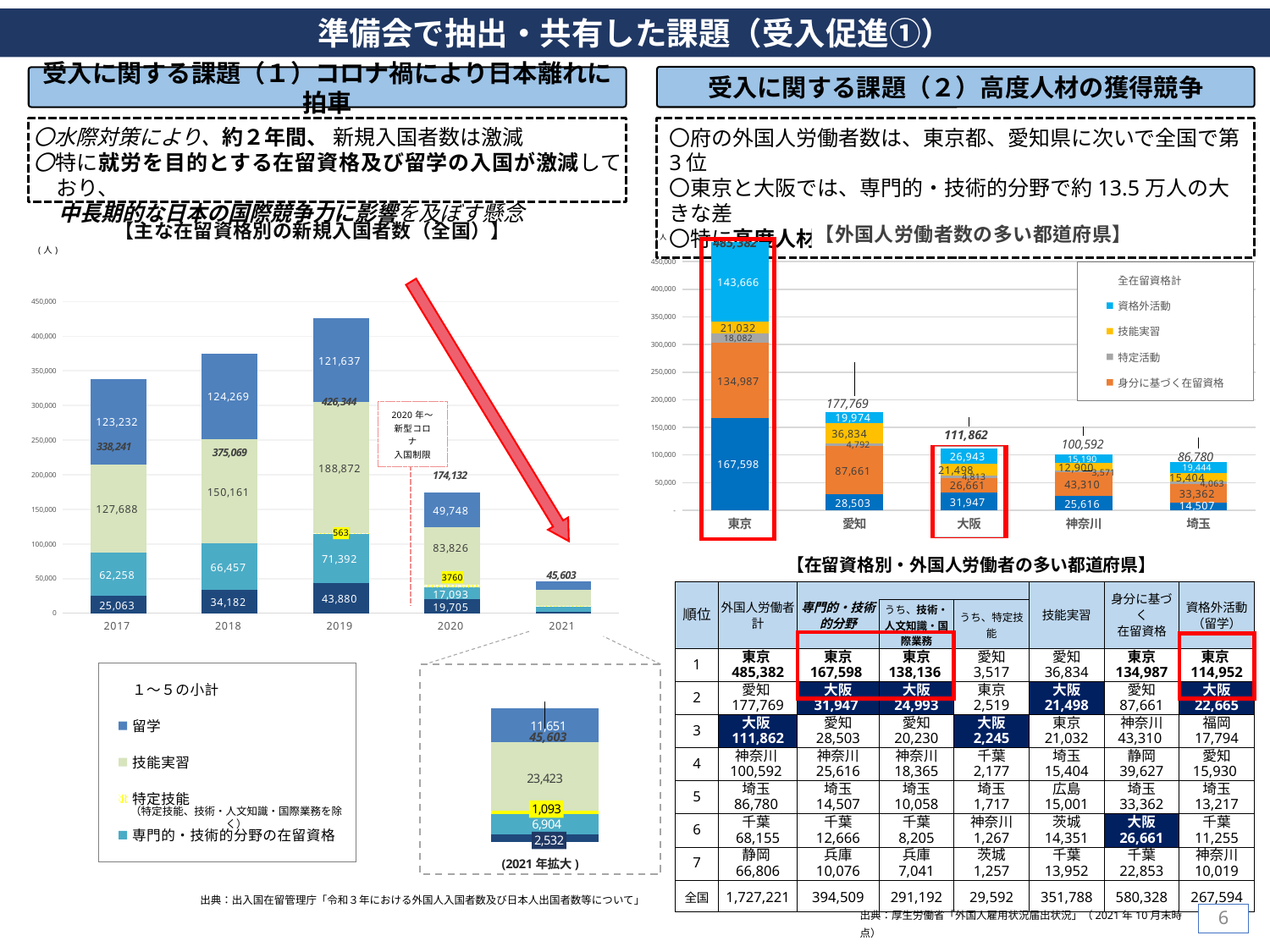
In the left chart 【主な在留資格別の新規入国者数（全国）】, what is the total for 2021? 45,603 What type of chart is the right chart 【外国人労働者数の多い都道府県】? Stacked bar chart In the right chart 【外国人労働者数の多い都道府県】, which is larger, the total for 愛知 or the total for 大阪? 愛知 In the left chart 【主な在留資格別の新規入国者数（全国）】, what is the total number of new entrants for 2019? 426,344 In the left chart 【主な在留資格別の新規入国者数（全国）】, which year has the lowest total? 2021 In the left chart 【主な在留資格別の新規入国者数（全国）】, what is the 技能実習 value for 2019? 188,872 In the left chart 【主な在留資格別の新規入国者数（全国）】, which year has the highest total? 2019 In the right chart 【外国人労働者数の多い都道府県】, what is the total number of foreign workers for 東京? 485,382 In the right chart 【外国人労働者数の多い都道府県】, what is the 身分に基づく在留資格 value for 神奈川? 43,310 In the left chart 【主な在留資格別の新規入国者数（全国）】, what is the difference between the 2019 total (426,344) and the 2020 total (174,132)? 252,212 In the right chart 【外国人労働者数の多い都道府県】, which prefecture has the lowest total? 埼玉 In the left chart 【主な在留資格別の新規入国者数（全国）】, how many years are shown on the x axis? 5